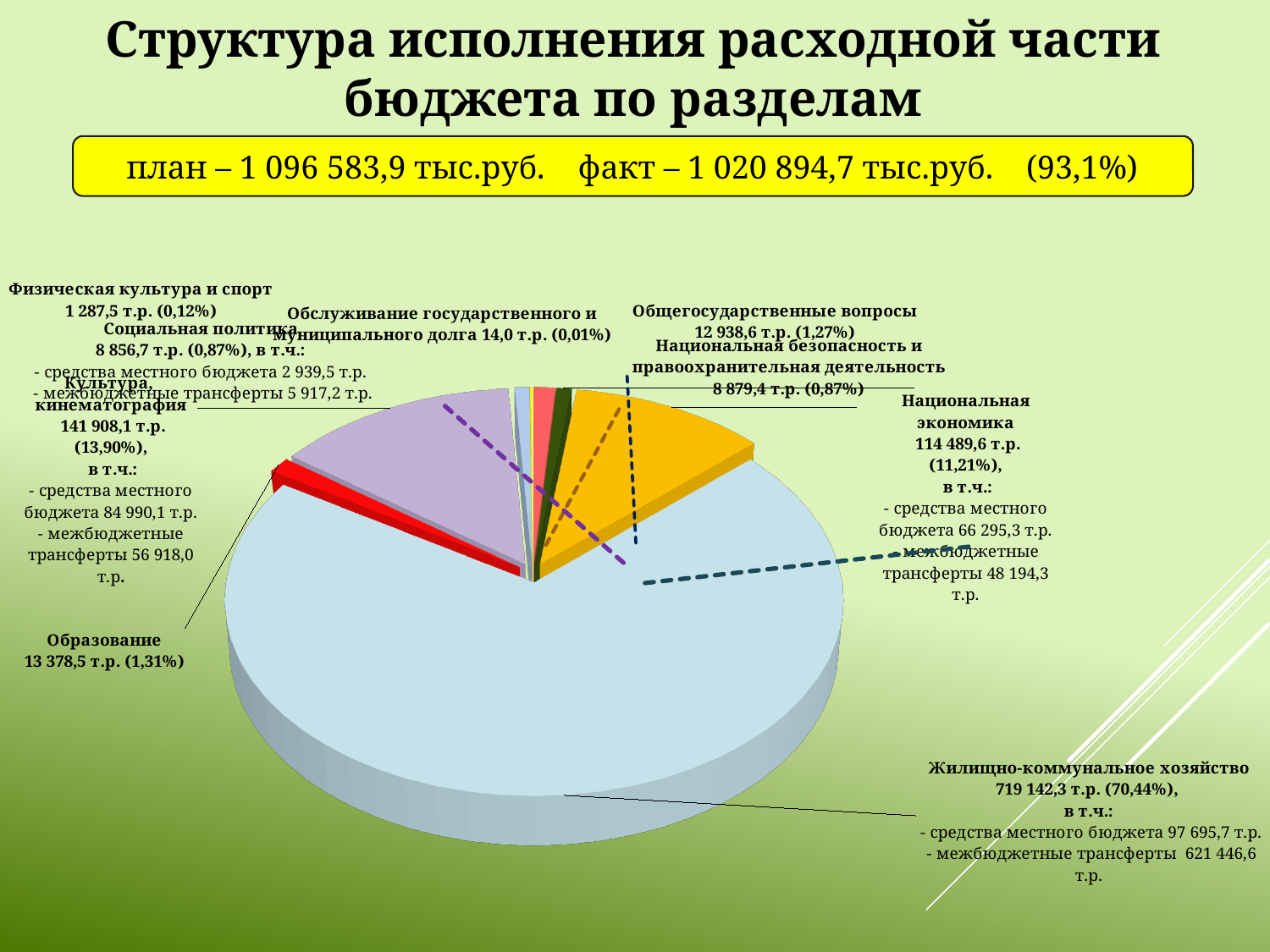
What is the value shown for Национальная экономика? 114 489,6 т.р. What is the title of the slide containing the chart? Структура исполнения расходной части бюджета по разделам Which is larger: Культура, кинематография or Национальная экономика? Культура, кинематография What kind of chart is shown on the slide? Pie chart What share of the pie does Культура, кинематография account for? 13,90% What is the value shown for Жилищно-коммунальное хозяйство? 719 142,3 т.р. What share of the pie does Образование account for? 1,31% What is the difference between the values for Культура, кинематография and Национальная экономика? 27 418,5 т.р. What is the value shown for Физическая культура и спорт? 1 287,5 т.р. How many sections (categories) are labelled on the pie chart? 9 Which section has the largest share of the pie chart? Жилищно-коммунальное хозяйство Which section has the smallest share of the pie chart? Обслуживание государственного и муниципального долга